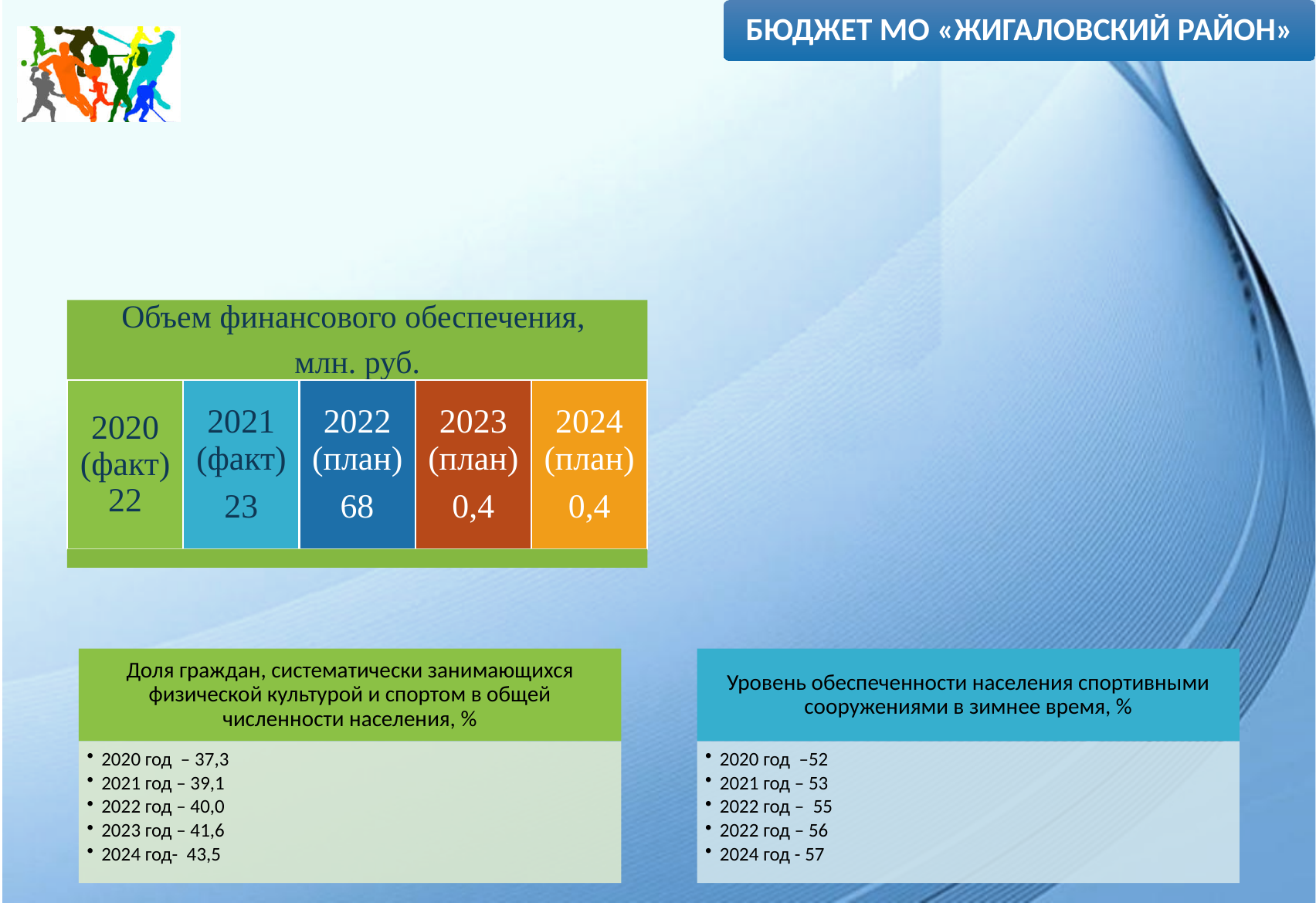
In the 'Объем финансового обеспечения, млн. руб.' block, what is the difference between the 2021 (факт) value and the 2020 (факт) value? 1 How many years are shown in the 'Объем финансового обеспечения, млн. руб.' block? 5 In the 'Объем финансового обеспечения, млн. руб.' block, what is the value for 2022 (план)? 68 In the 'Объем финансового обеспечения, млн. руб.' block, what is the value for 2021 (факт)? 23 In the 'Объем финансового обеспечения, млн. руб.' block, which year has the highest value? 2022 (план) In the 'Объем финансового обеспечения, млн. руб.' block, what is the difference between the 2022 (план) value and the 2021 (факт) value? 45 In the 'Объем финансового обеспечения, млн. руб.' block, what is the value for 2020 (факт)? 22 In the 'Объем финансового обеспечения, млн. руб.' block, which is larger: the value for 2020 (факт) or the value for 2023 (план)? 2020 (факт) In the 'Уровень обеспеченности населения спортивными сооружениями в зимнее время, %' box, what is the value for 2020? 52 In the 'Объем финансового обеспечения, млн. руб.' block, what is the value for 2024 (план)? 0,4 In the 'Доля граждан, систематически занимающихся физической культурой и спортом в общей численности населения, %' box, what is the value for 2024? 43,5 In the 'Объем финансового обеспечения, млн. руб.' block, which years are marked as 'факт'? 2020 and 2021